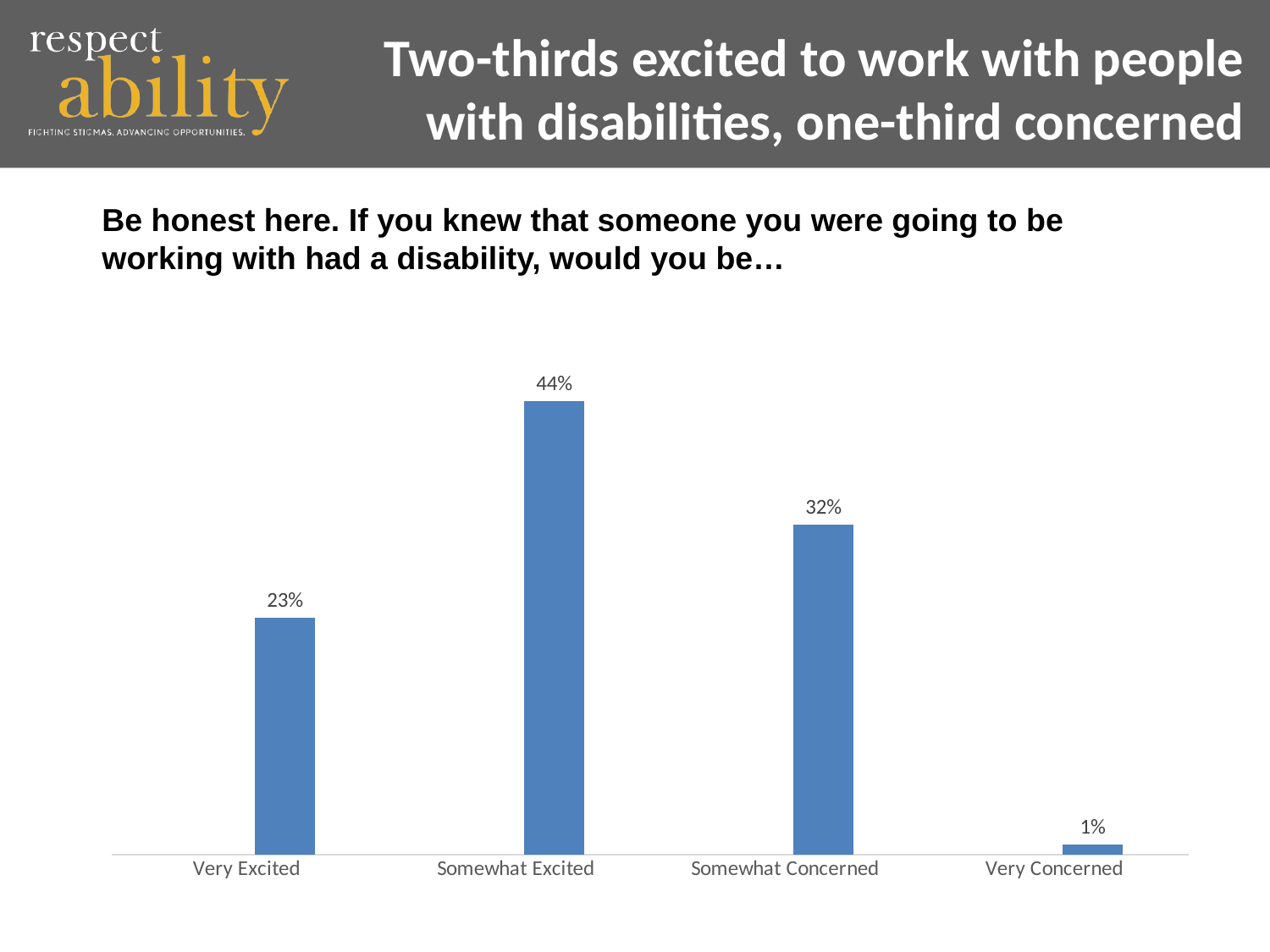
Which response category has the lowest percentage? Very Concerned What is the difference in percentage points between Very Excited and Very Concerned? 22 What percentage of respondents said they would be Somewhat Excited? 44% How many response categories are shown in the chart? 4 What is the combined percentage of Very Excited and Somewhat Excited responses? 67% Which response category has the highest percentage? Somewhat Excited What is the difference in percentage points between Somewhat Excited and Somewhat Concerned? 12 What type of chart is shown on the slide? Bar chart What percentage of respondents said they would be Very Concerned? 1% Which is larger, the percentage for Very Excited or for Somewhat Concerned? Somewhat Concerned What percentage of respondents said they would be Somewhat Concerned? 32% What percentage of respondents said they would be Very Excited? 23%